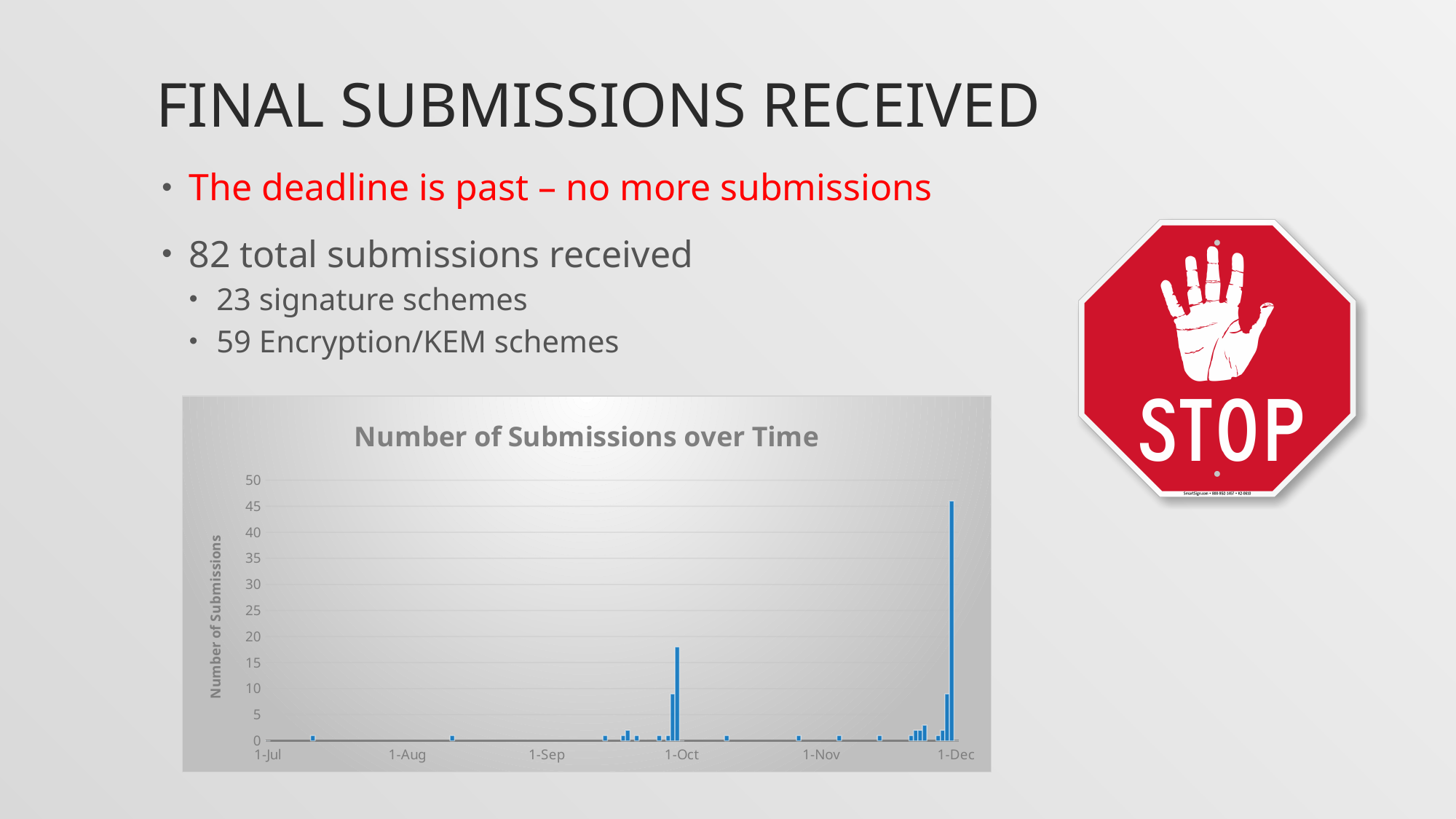
How many date labels are shown along the x axis of the chart? 6 What is the label on the vertical axis of the chart? Number of Submissions Is the value of the tallest bar near 1-Oct greater or less than 15? greater Is the value of the tallest bar in the chart greater or less than 40? greater Is the value of the bar just after 1-Jul greater or less than 5? less Around which x-axis date does the tallest bar in the chart appear? 1-Dec What is the title of the chart? Number of Submissions over Time What kind of chart is shown on the slide? bar chart Which is larger: the tallest bar near 1-Oct or the tallest bar near 1-Dec? the tallest bar near 1-Dec